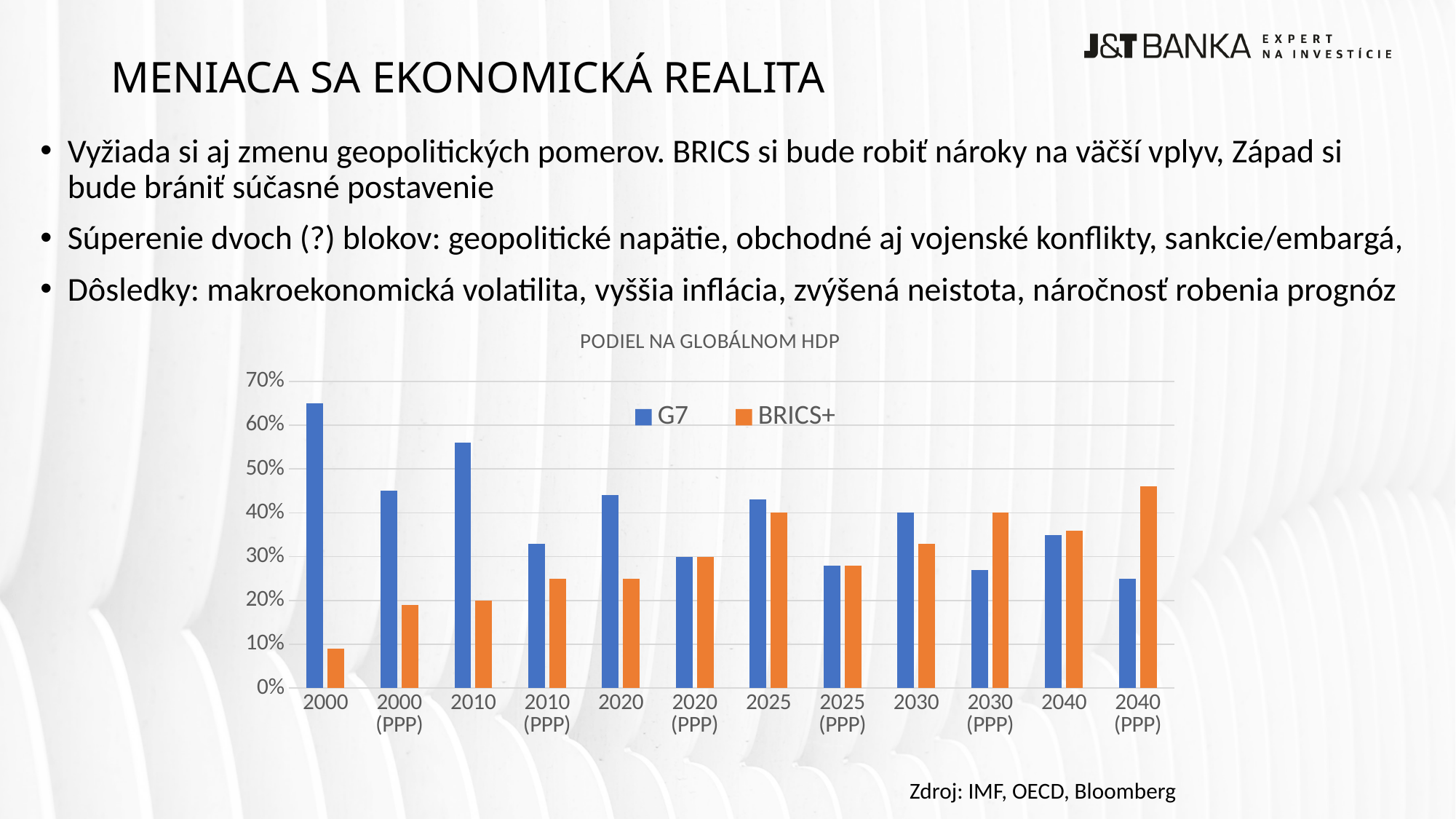
What kind of chart is shown on the slide? bar chart Which category has the highest G7 value? 2000 Is the G7 value for 2000 greater or less than 60%? greater How many series does the chart legend list? 2 What is the title of the chart? PODIEL NA GLOBÁLNOM HDP Which category has the lowest BRICS+ value? 2000 Do the G7 values rise or fall from 2000 to 2040 (non-PPP categories)? fall How many categories are shown on the x axis of the chart? 12 Is the G7 value for 2040 (PPP) greater or less than 30%? less In 2030 (PPP), which series has the larger value, G7 or BRICS+? BRICS+ Which category has the highest BRICS+ value? 2040 (PPP)